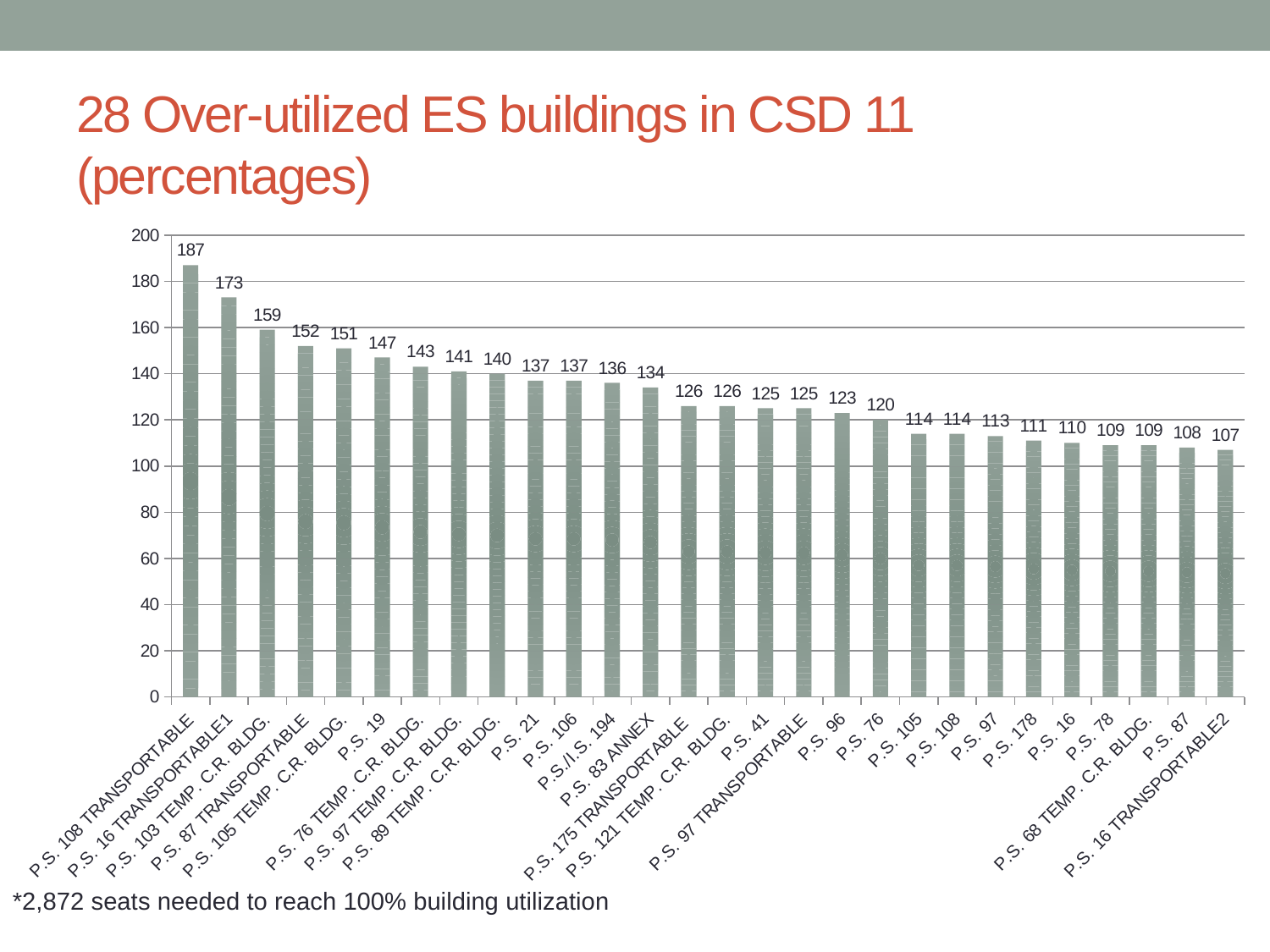
Which building has the highest value? P.S. 108 TRANSPORTABLE What is the value for P.S. 83 ANNEX? 134 Do the values rise or fall from left to right along the x axis? fall How many buildings are shown in the chart? 28 Which has a larger value, P.S. 21 or P.S. 41? P.S. 21 What kind of chart is shown on the slide? bar chart What is the difference between the highest value (P.S. 108 TRANSPORTABLE) and the lowest value (P.S. 16 TRANSPORTABLE2)? 80 Which building has the lowest value? P.S. 16 TRANSPORTABLE2 What is the value for P.S. 19? 147 According to the footnote, how many seats are needed to reach 100% building utilization? 2,872 Is the value for P.S. 76 greater or less than 140? less What is the value for P.S. 96? 123